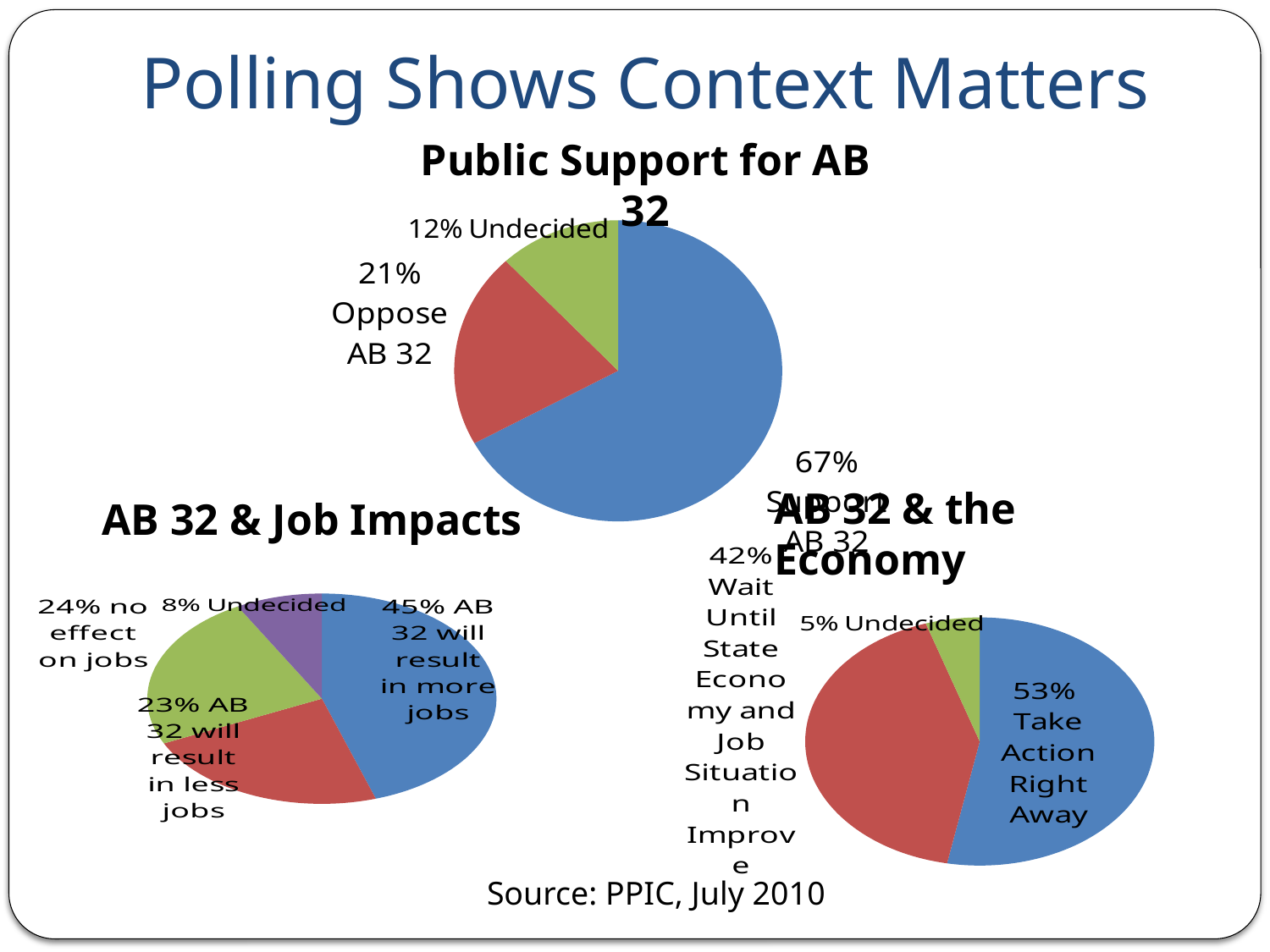
In the 'Public Support for AB 32' pie chart, what is the difference between the share that supports AB 32 and the share that opposes it? 46% In the 'AB 32 & Job Impacts' pie chart, which slice is the smallest? Undecided In the 'Public Support for AB 32' pie chart, what share of respondents oppose AB 32? 21% In the 'Public Support for AB 32' pie chart, what share of respondents support AB 32? 67% In the 'Public Support for AB 32' pie chart, what share of respondents are undecided? 12% What type of chart is used for 'AB 32 & the Economy'? Pie chart In the 'AB 32 & the Economy' pie chart, what is the difference between the share wanting to take action right away and the share wanting to wait until the state economy and job situation improve? 11% In the 'AB 32 & Job Impacts' pie chart, which is larger: the share saying AB 32 will result in less jobs or the share saying no effect on jobs? no effect on jobs In the 'AB 32 & Job Impacts' pie chart, how many slices are there? 4 In the 'Public Support for AB 32' pie chart, which slice is the largest? Support AB 32 In the 'AB 32 & the Economy' pie chart, what share of respondents want to take action right away? 53% In the 'AB 32 & Job Impacts' pie chart, what share of respondents think AB 32 will result in more jobs? 45%